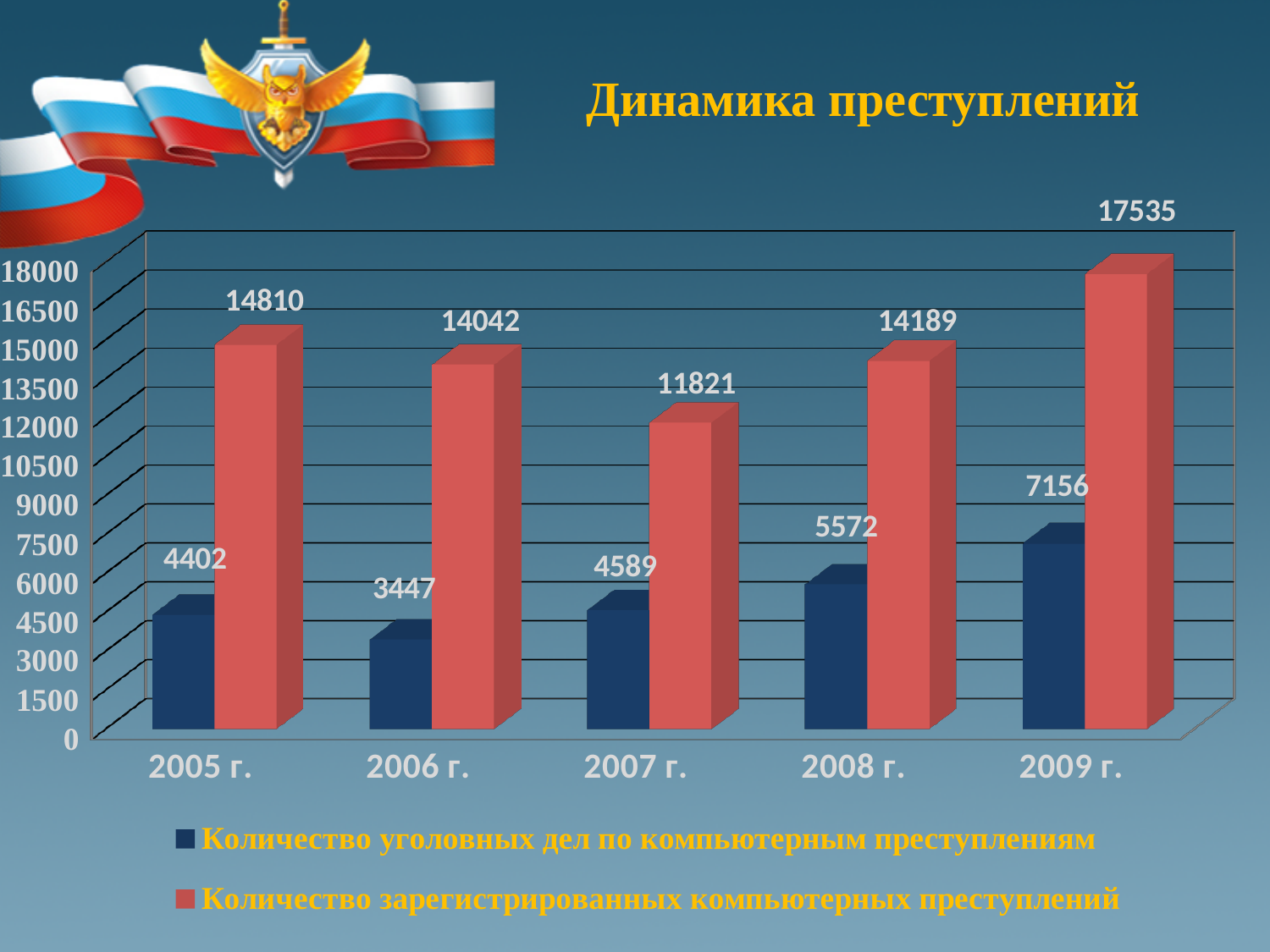
In which year is "Количество уголовных дел по компьютерным преступлениям" the lowest? 2006 г. Does "Количество уголовных дел по компьютерным преступлениям" rise or fall from 2006 г. to 2009 г.? Rise What is the value of "Количество уголовных дел по компьютерным преступлениям" for 2005 г.? 4402 Which is larger: "Количество уголовных дел по компьютерным преступлениям" in 2009 г. or in 2008 г.? 2009 г. In which year is "Количество зарегистрированных компьютерных преступлений" the highest? 2009 г. How many years are shown on the x axis? 5 What kind of chart is shown on the slide? Bar chart What is the difference between "Количество зарегистрированных компьютерных преступлений" and "Количество уголовных дел по компьютерным преступлениям" in 2008 г.? 8617 What is the value of "Количество зарегистрированных компьютерных преступлений" for 2009 г.? 17535 What is the title of the slide? Динамика преступлений What is the value of "Количество зарегистрированных компьютерных преступлений" for 2007 г.? 11821 How many series does the legend list? 2